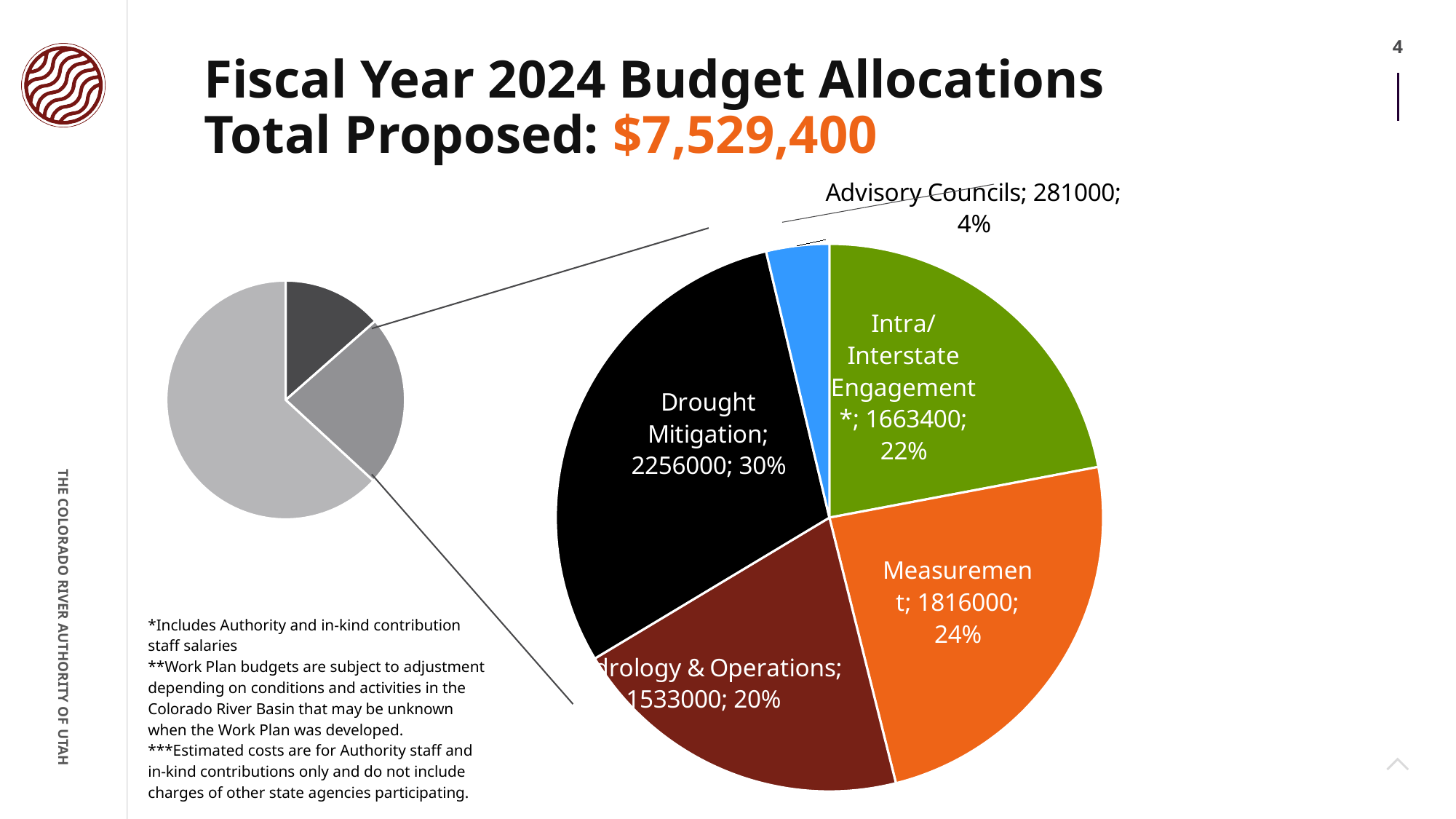
What is the value shown for Drought Mitigation in the pie chart? 2256000 Which category has the smallest slice in the pie chart? Advisory Councils What is the difference between the Drought Mitigation value and the Measurement value? 440000 Which category has the largest slice in the pie chart? Drought Mitigation What total proposed budget is stated in the slide title? $7,529,400 What is the value shown for Advisory Councils? 281000 What percentage of the budget does the Measurement slice represent? 24% What is the value shown for Hydrology & Operations? 1533000 What kind of chart is shown on the slide? Pie chart How many labeled slices are in the large pie chart on the right? 5 What share of the budget goes to Intra/Interstate Engagement? 22% Which is larger, Intra/Interstate Engagement or Measurement? Measurement